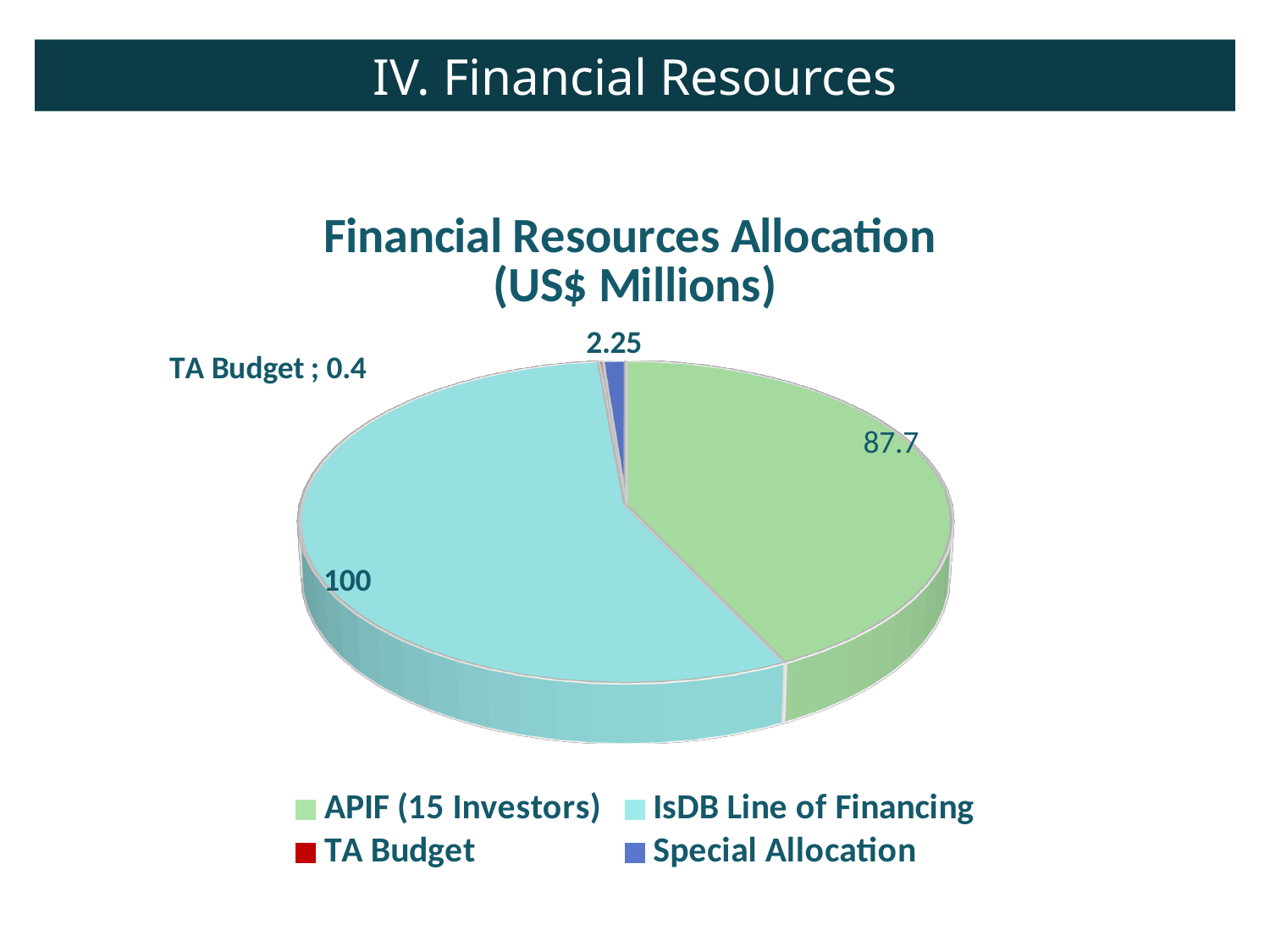
Which is larger, the value for APIF (15 Investors) or the value for Special Allocation? APIF (15 Investors) What is the value for IsDB Line of Financing in the Financial Resources Allocation chart? 100 What is the value for Special Allocation in the Financial Resources Allocation chart? 2.25 What kind of chart is shown on the slide? Pie chart In what units are the values in the Financial Resources Allocation chart expressed, according to its title? US$ Millions Which category has the largest slice in the Financial Resources Allocation chart? IsDB Line of Financing What is the difference between the Special Allocation value and the TA Budget value? 1.85 What is the value for APIF (15 Investors) in the Financial Resources Allocation chart? 87.7 How many categories does the Financial Resources Allocation pie chart have? 4 Which category has the smallest slice in the Financial Resources Allocation chart? TA Budget How much larger is the IsDB Line of Financing value than the APIF (15 Investors) value? 12.3 What is the value for TA Budget in the Financial Resources Allocation chart? 0.4